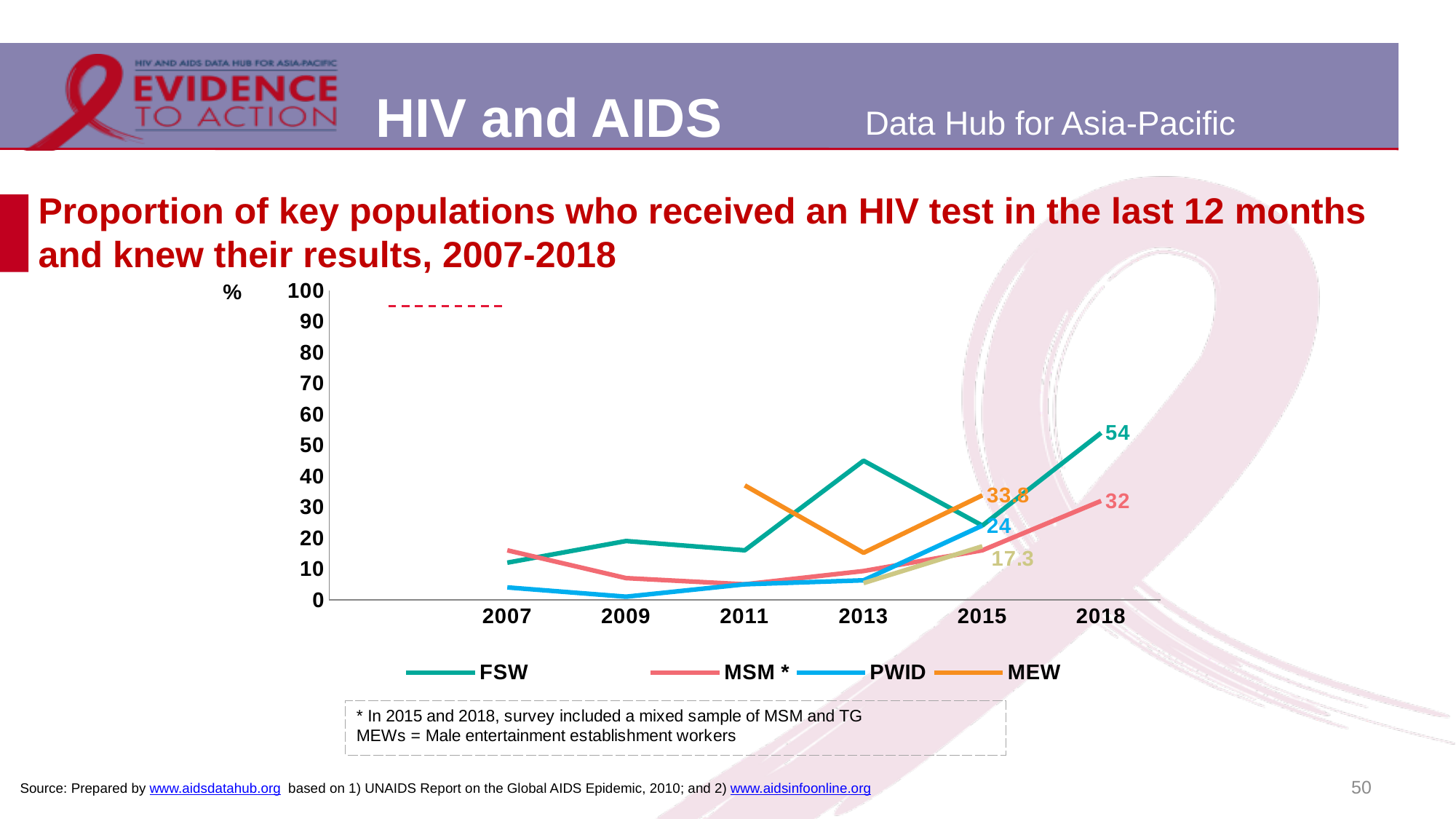
How many years are shown on the x axis? 6 Is the value for FSW in 2013 greater or less than 40? greater What is the difference between the FSW and MSM * values in 2018? 22 How many series does the legend list? 4 What is the value for FSW in 2018? 54 What is the value for MEW in 2015? 33.8 Which is larger in 2015, the value for MEW or the value for PWID? MEW Which series has the highest value in 2018? FSW Does the FSW line rise or fall from 2015 to 2018? rise What is the value for MSM * in 2018? 32 What is the value for PWID in 2015? 24 What kind of chart is shown on the slide? line chart